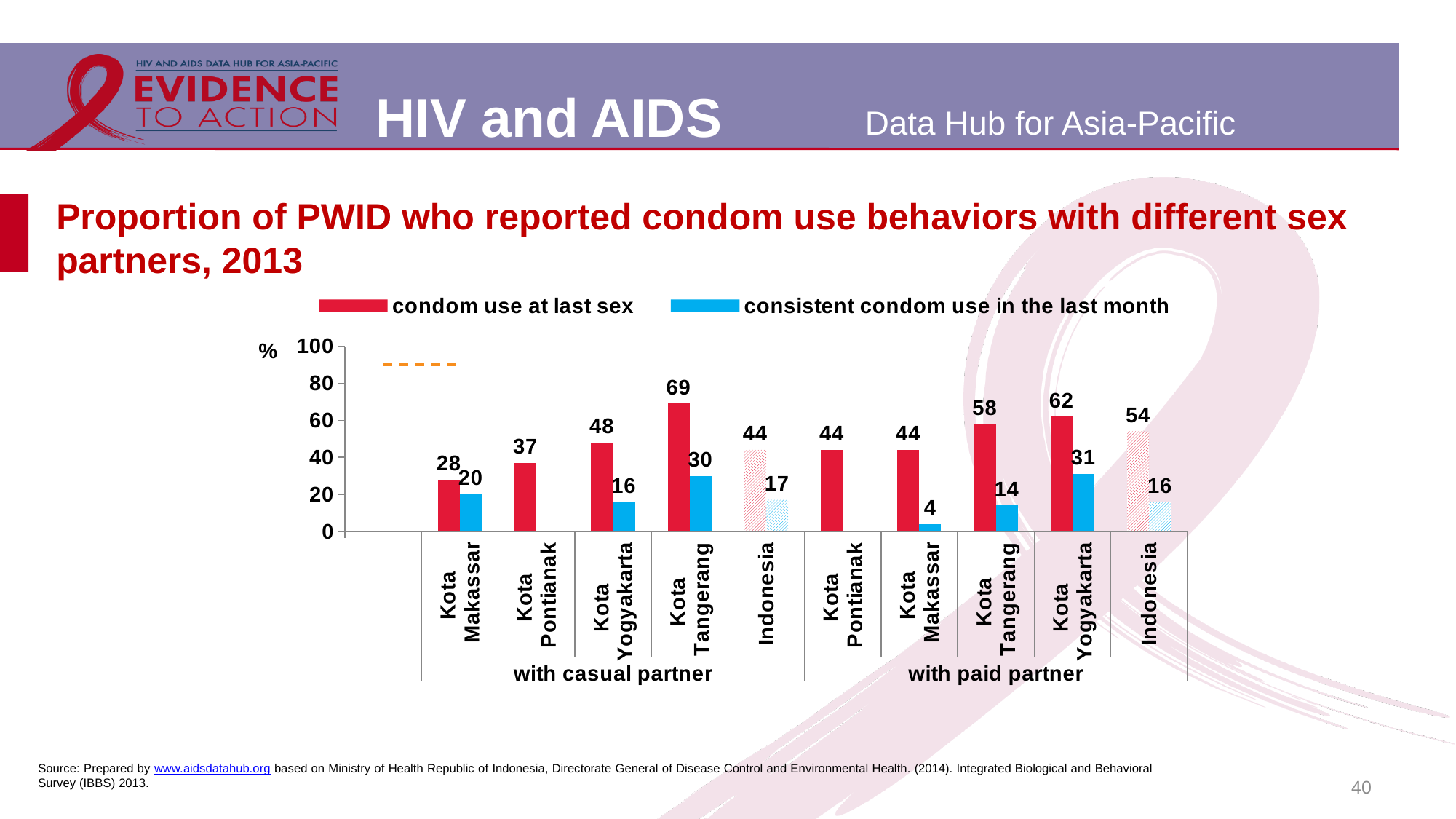
Which colour represents consistent condom use in the last month in the legend? blue What is the difference between consistent condom use in the last month with casual partner and with paid partner for Indonesia? 1 How many series does the legend list? 2 How many location categories are shown under 'with paid partner'? 5 Which is larger: condom use at last sex with paid partner in Kota Yogyakarta or in Kota Tangerang? Kota Yogyakarta What is the value for condom use at last sex with paid partner for Indonesia? 54 What is the difference between condom use at last sex and consistent condom use in the last month with casual partner in Kota Yogyakarta? 32 What is the value for condom use at last sex with casual partner in Kota Tangerang? 69 What kind of chart is shown on the slide? bar chart Which location has the highest value for condom use at last sex with casual partner? Kota Tangerang What is the value for consistent condom use in the last month with paid partner in Kota Makassar? 4